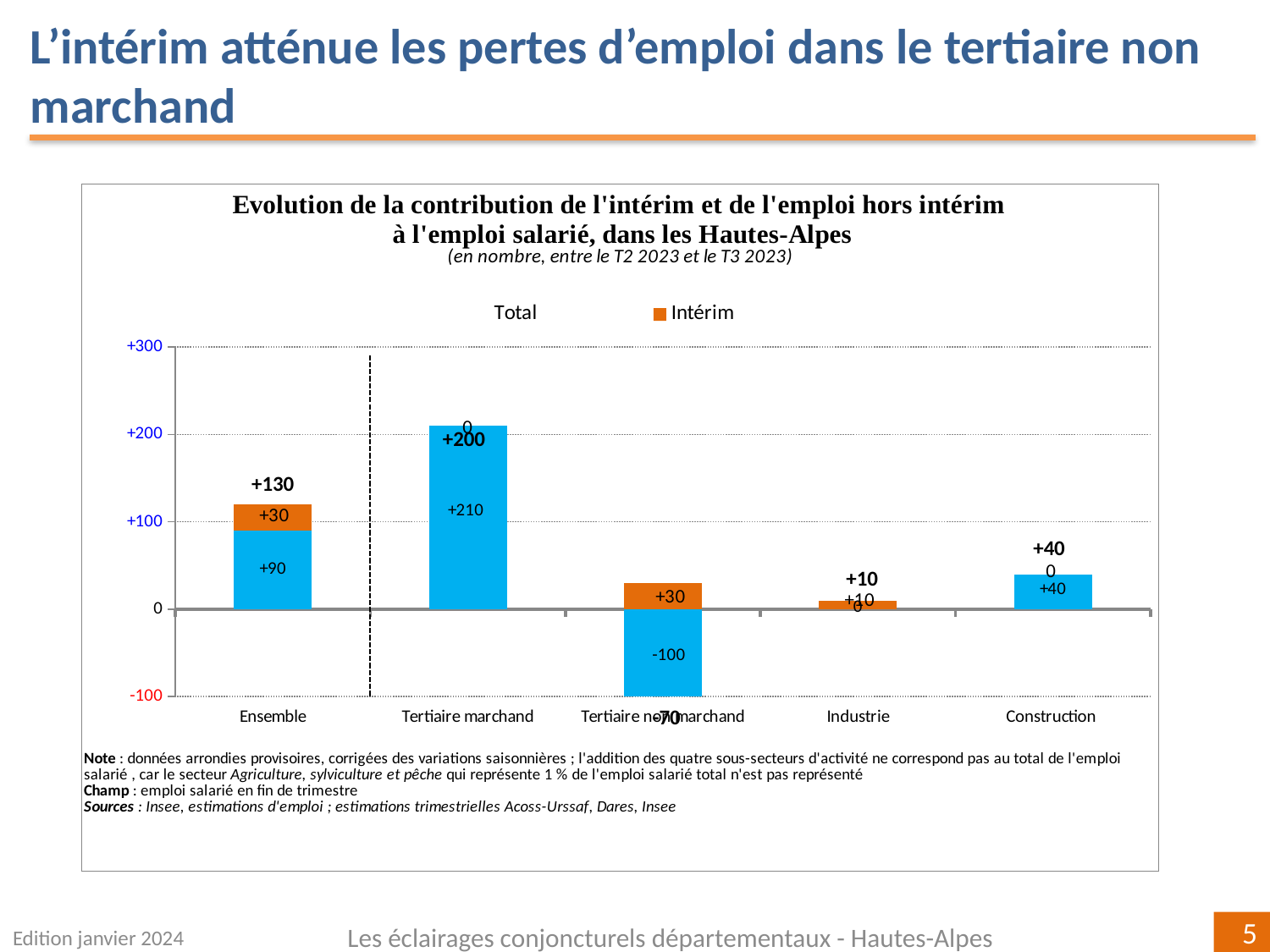
What is the value of the blue bar for Ensemble? +90 What is the value of the blue bar for Tertiaire marchand? +210 What is the difference between the blue bar value and the Intérim value for Ensemble? 60 What is the Intérim value for Ensemble? +30 What is the total label shown above the Ensemble bar? +130 How many categories are shown on the x axis? 5 Which category has the lowest blue bar value? Tertiaire non marchand Which category has the highest total label? Tertiaire marchand What kind of chart is this? bar chart What is the value of the blue bar for Tertiaire non marchand? -100 What is the Intérim value for Industrie? +10 How many series does the legend list? 2